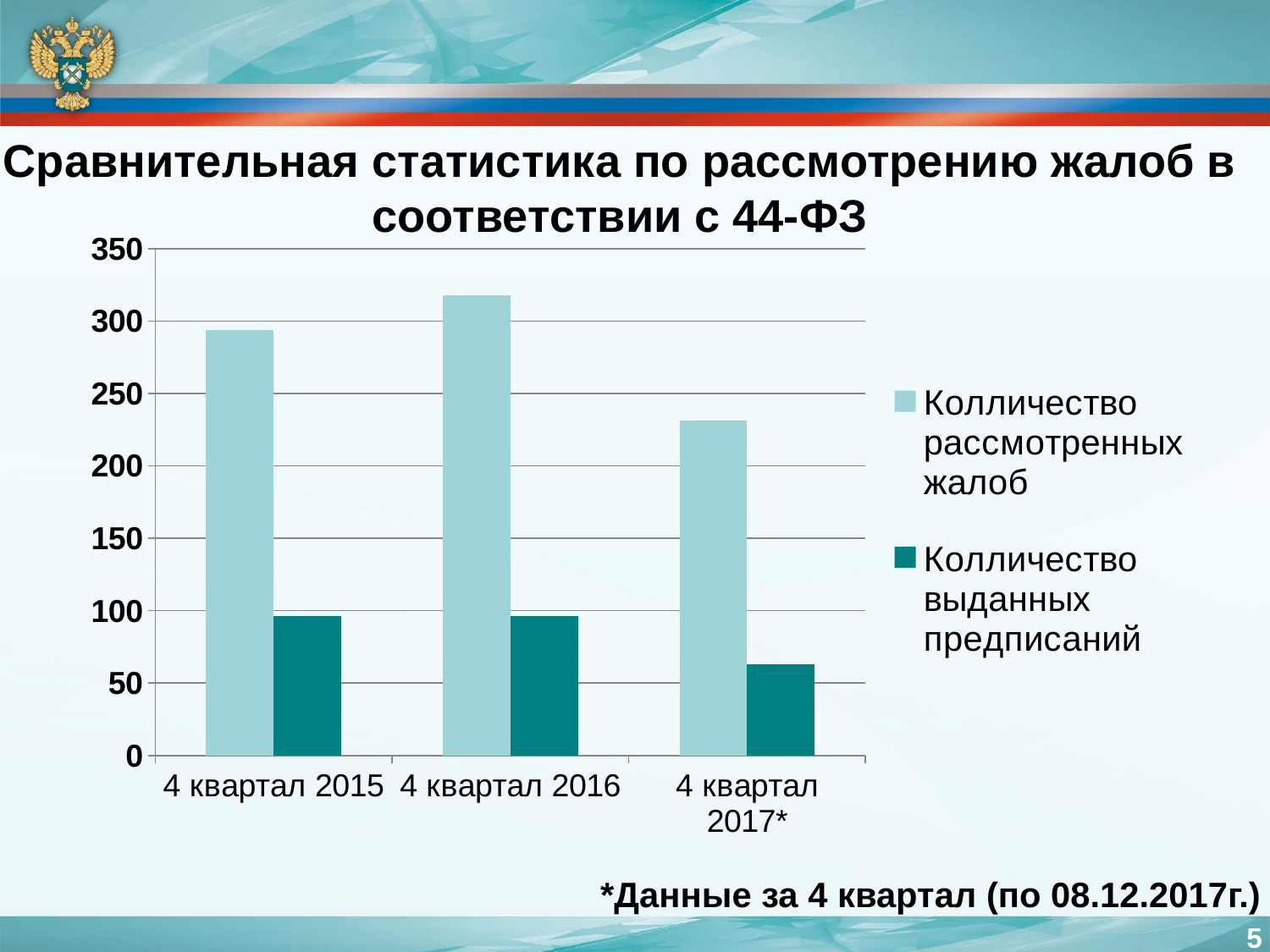
In which quarter is the number of reviewed complaints (Колличество рассмотренных жалоб) the highest? 4 квартал 2016 How many series does the legend list? 2 Is the number of issued orders for 4 квартал 2017* greater or less than 50? greater Is the number of reviewed complaints for 4 квартал 2017* greater or less than 250? less In which quarter is the number of reviewed complaints (Колличество рассмотренных жалоб) the lowest? 4 квартал 2017* How many categories are shown on the x axis? 3 In which quarter is the number of issued orders (Колличество выданных предписаний) the lowest? 4 квартал 2017* Is the number of reviewed complaints for 4 квартал 2015 greater or less than 250? greater What is the title of the chart? Сравнительная статистика по рассмотрению жалоб в соответствии с 44-ФЗ Which is larger: the number of reviewed complaints in 4 квартал 2016 or in 4 квартал 2017*? 4 квартал 2016 What kind of chart is shown on the slide? bar chart